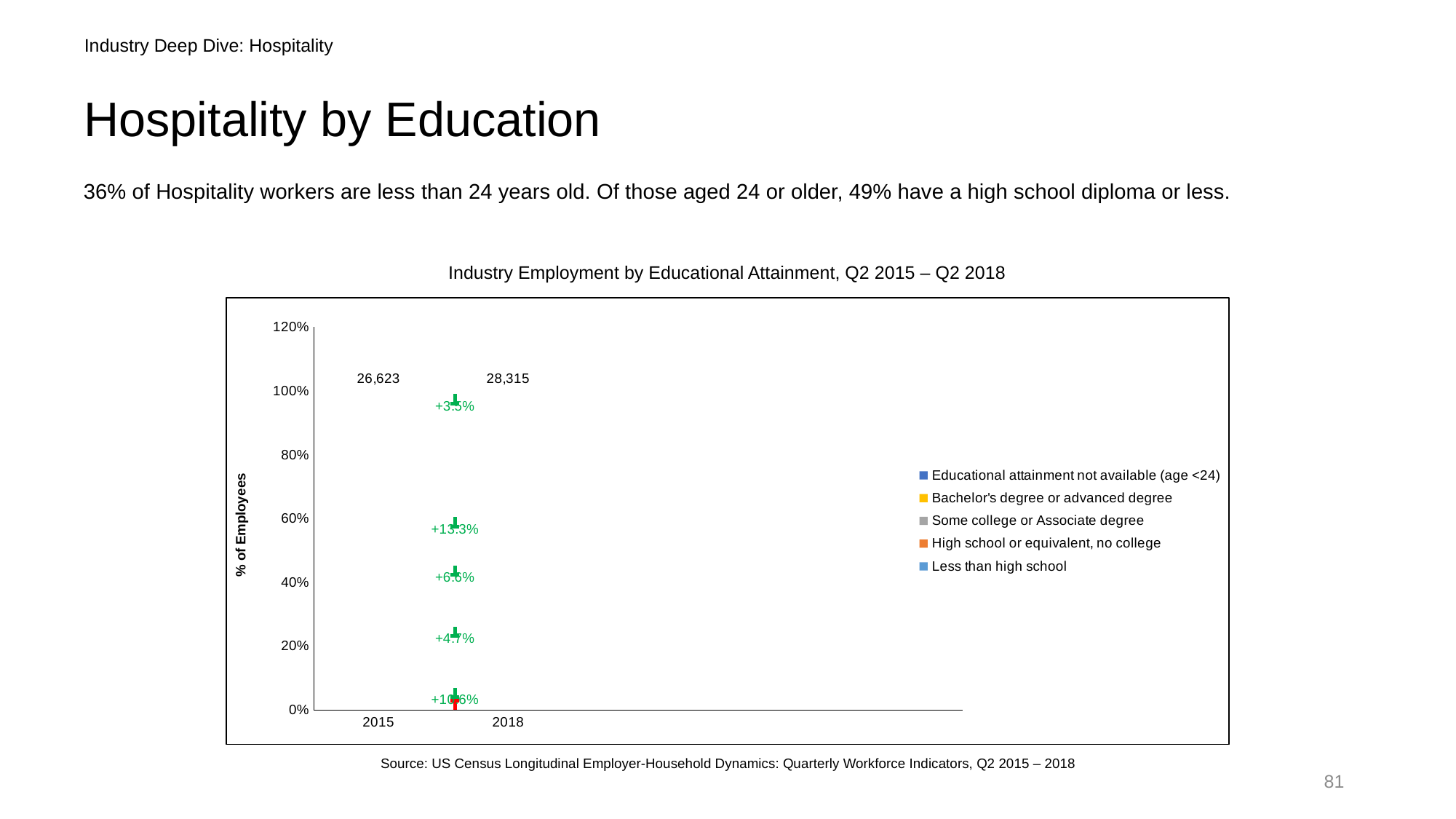
What percentage change is printed next to the green marker near the 20% level? +4.7% What percentage change is printed next to the topmost green marker in the chart? +3.5% How many years are shown on the x axis of the chart? 2 Which year has the larger total employment figure, 2015 or 2018? 2018 What is the title of the chart? Industry Employment by Educational Attainment, Q2 2015 – Q2 2018 What total employment figure is printed above the 2018 bar? 28,315 What total employment figure is printed above the 2015 bar? 26,623 What percentage change is printed next to the green marker near the 40% level? +6.6% What is the label on the y axis of the chart? % of Employees How many series does the chart legend list? 5 What percentage change is printed next to the green marker near the 60% level? +13.3% What is the difference between the 2018 and 2015 total employment figures? 1,692